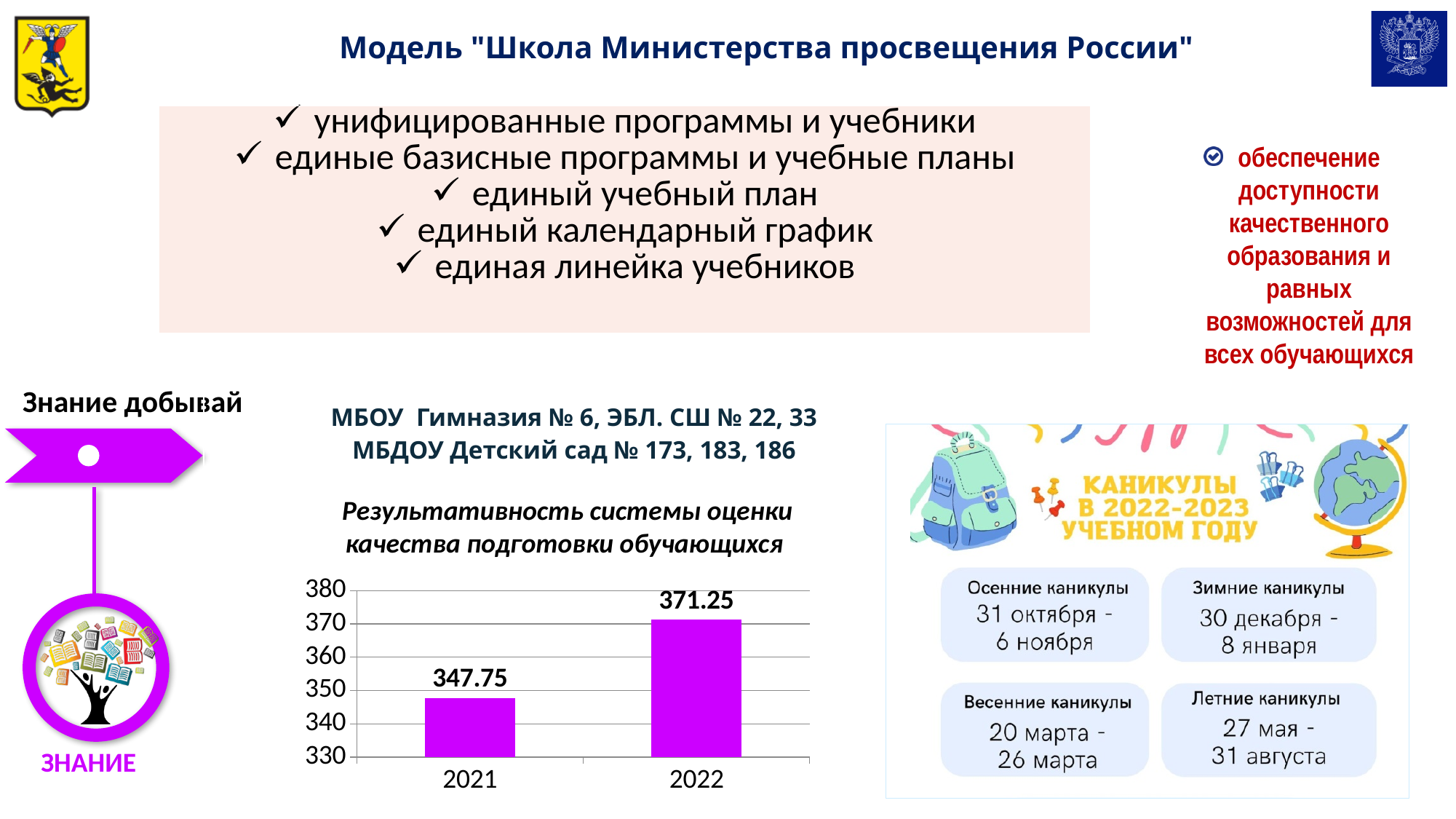
Is the value for 2021 greater or less than 350? less Which year has the lower value in the chart? 2021 Do the values rise or fall from 2021 to 2022? rise Is the value for 2022 greater or less than 370? greater What is the difference between the 2022 and 2021 values in the chart? 23.5 What is the value for 2022 in the chart? 371.25 Which year has the higher value in the chart? 2022 How many categories (years) are shown in the chart? 2 What kind of chart is shown on the slide? bar chart Is the value for 2022 larger or smaller than the value for 2021? larger What is the value for 2021 in the chart? 347.75 What is the title of the chart? Результативность системы оценки качества подготовки обучающихся